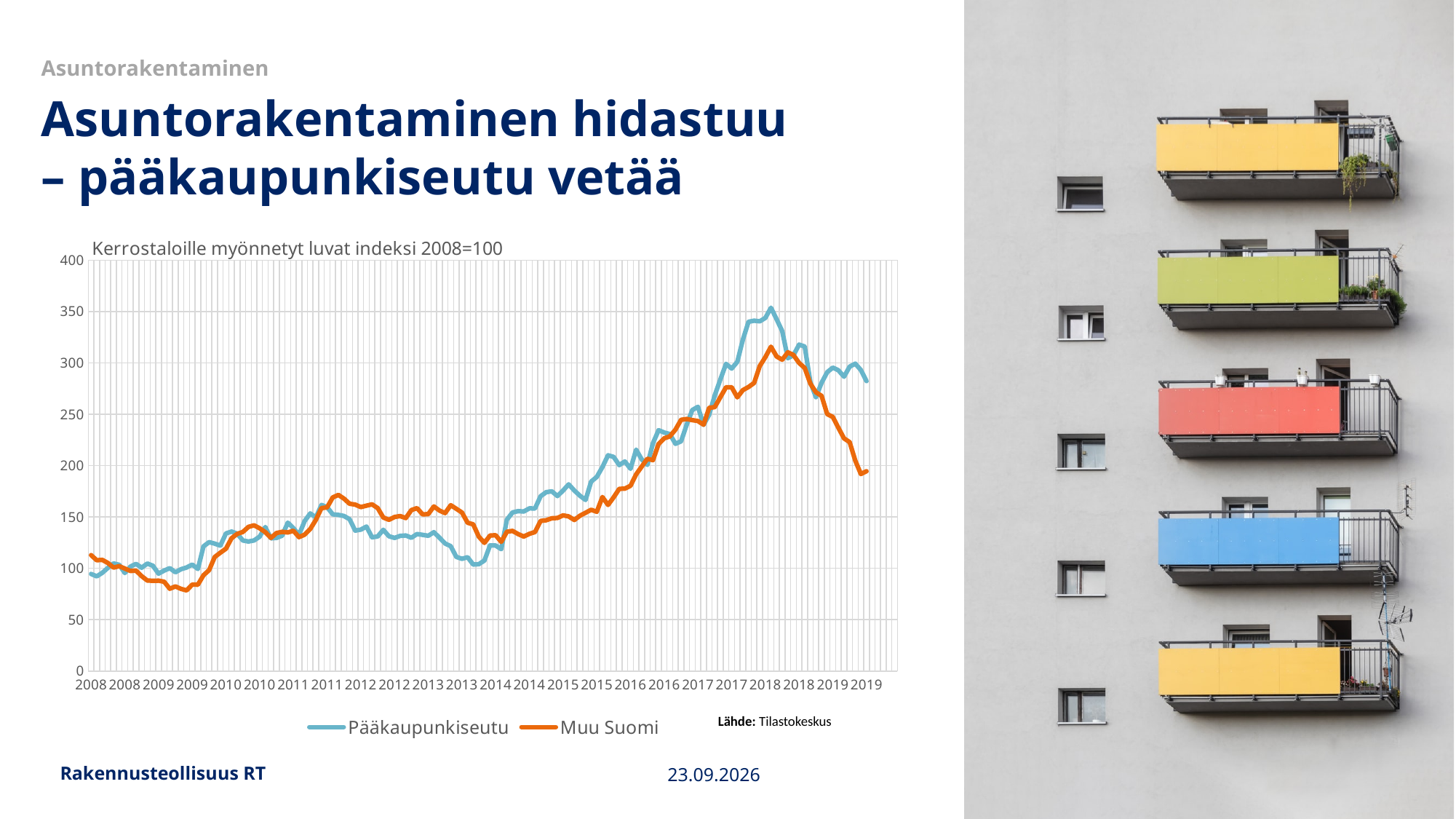
Is the final 2019 value of the Pääkaupunkiseutu line greater or less than 250? greater Do both lines rise or fall between 2014 and their 2018 peaks? rise At the end of the series in 2019, which line is higher, Pääkaupunkiseutu or Muu Suomi? Pääkaupunkiseutu Which series is drawn in orange in the chart? Muu Suomi How many series does the chart legend list? 2 Is the lowest value of the Muu Suomi line in 2009 greater or less than 100? less What is the title of the chart? Kerrostaloille myönnetyt luvat indeksi 2008=100 What kind of chart is shown on the slide? line chart Is the final 2019 value of the Muu Suomi line greater or less than 250? less Which series reaches the higher peak value in the chart, Pääkaupunkiseutu or Muu Suomi? Pääkaupunkiseutu